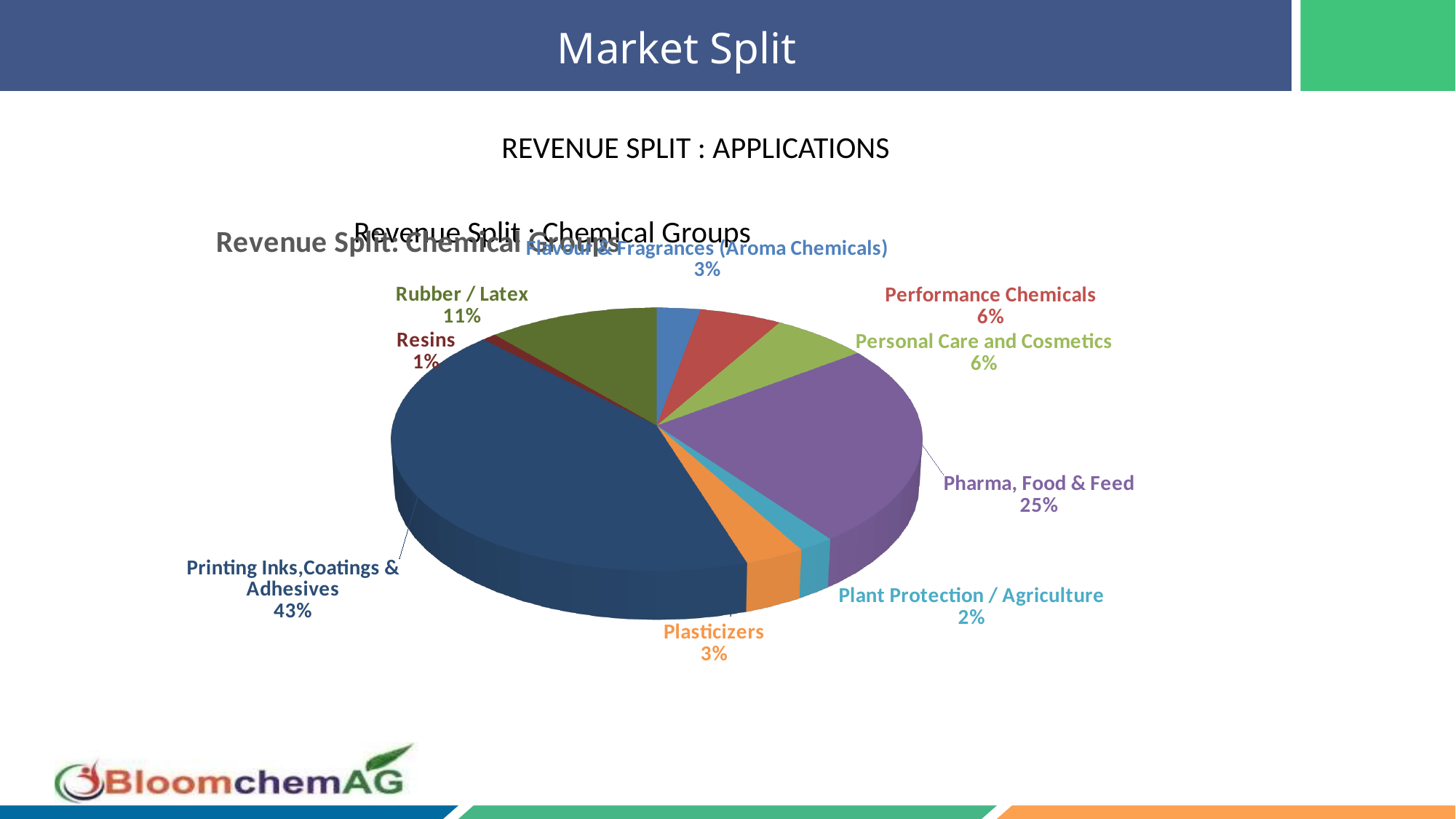
Which category has the smallest share of the pie? Resins What is the difference in share between Printing Inks, Coatings & Adhesives and Pharma, Food & Feed? 18% What share of revenue comes from Rubber / Latex? 11% What share of revenue comes from Plant Protection / Agriculture? 2% What share of revenue comes from Pharma, Food & Feed? 25% What share of revenue comes from Resins? 1% How many categories are shown in the pie chart? 9 What kind of chart is shown on the slide? Pie chart Which has a larger share, Rubber / Latex or Performance Chemicals? Rubber / Latex Which category has the largest share of the pie? Printing Inks, Coatings & Adhesives What share of revenue comes from Printing Inks, Coatings & Adhesives? 43%